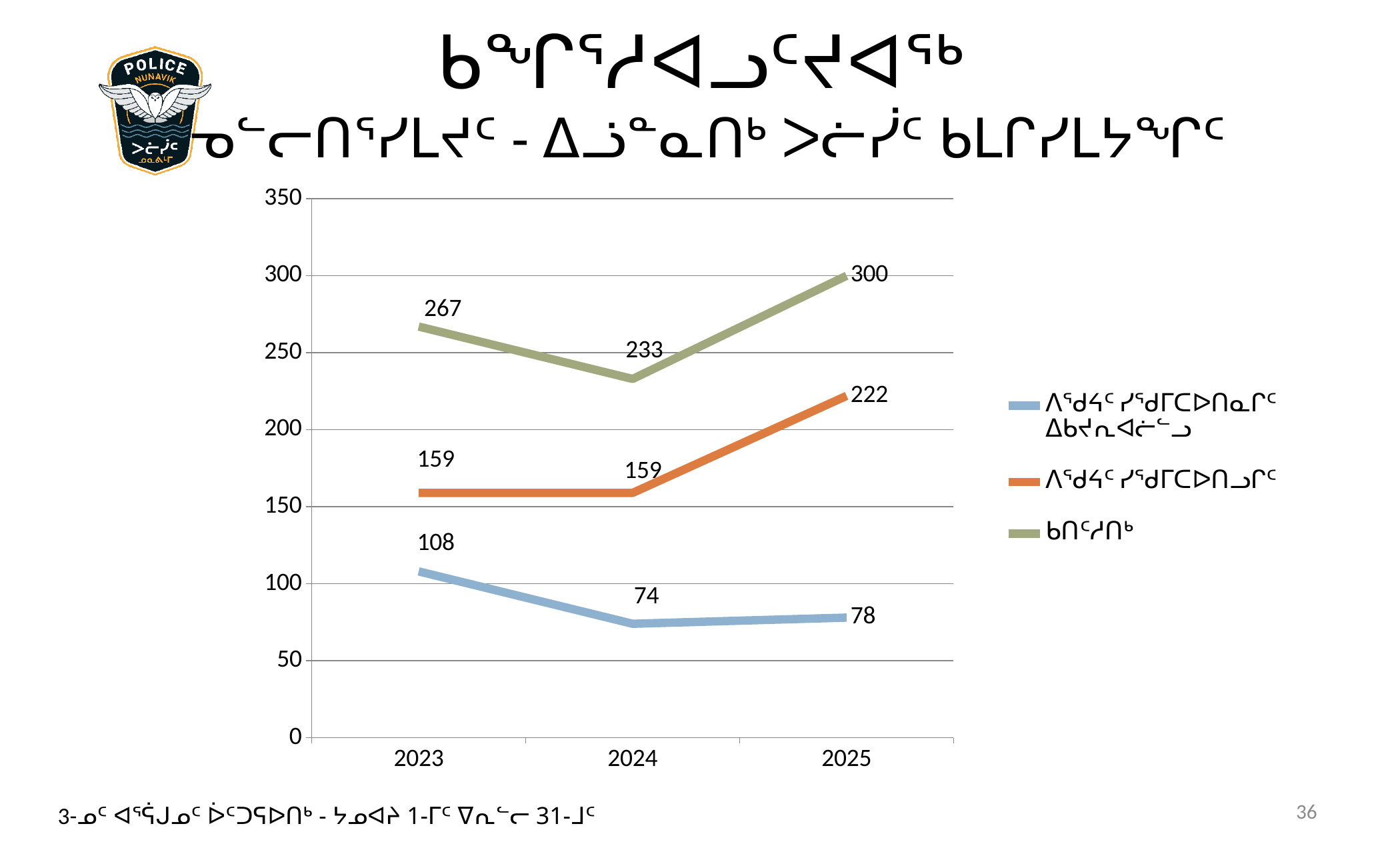
What is the value of the green (top) line in 2023? 267 For the blue line, which year has the larger value, 2023 or 2025? 2023 How many years are plotted along the x axis? 3 What is the value of the blue (bottom) line in 2024? 74 How many series does the legend list? 3 What is the value of the orange (middle) line in 2025? 222 What is the difference between the orange line's 2025 value and its 2023 value? 63 Does the orange line rise or fall from 2024 to 2025? rise In which year does the green line reach its highest value? 2025 What kind of chart is shown on the slide? line chart In which year does the blue line reach its lowest value? 2024 By how much does the green line increase from 2024 to 2025? 67